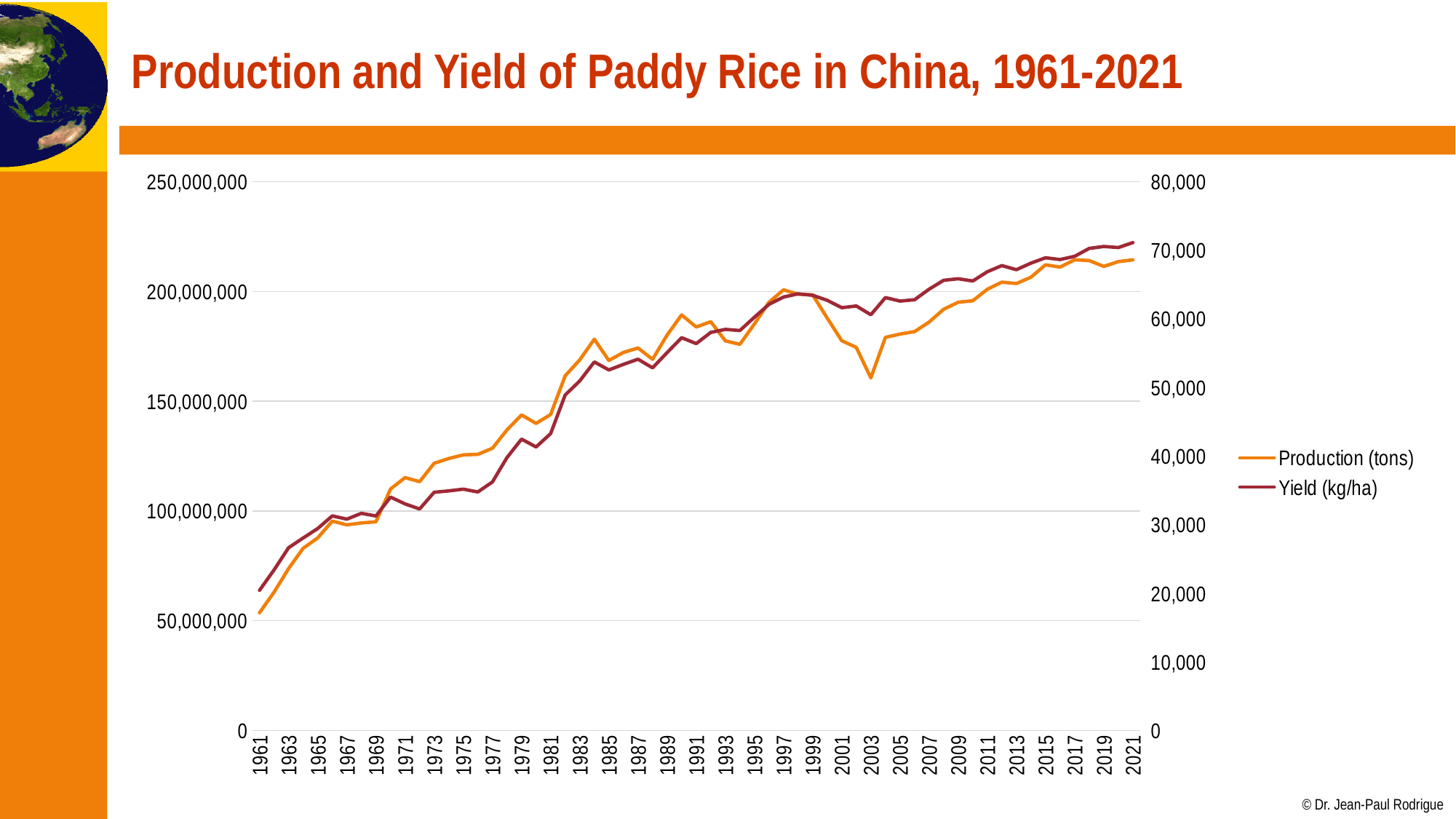
What are the two series named in the legend? Production (tons) and Yield (kg/ha) Is the Production (tons) value for 1961 greater or less than 100,000,000? less In which year is the Production (tons) series at its lowest? 1961 Which year has the higher Production (tons) value, 1997 or 2003? 1997 Is the Yield (kg/ha) value for 2021 greater or less than 60,000? greater How many series does the legend list? 2 Is the Production (tons) value for 2021 greater or less than 200,000,000? greater What kind of chart is shown on the slide? line chart Overall, does the Yield (kg/ha) series rise or fall from 1961 to 2021? rise What is the title of the chart? Production and Yield of Paddy Rice in China, 1961-2021